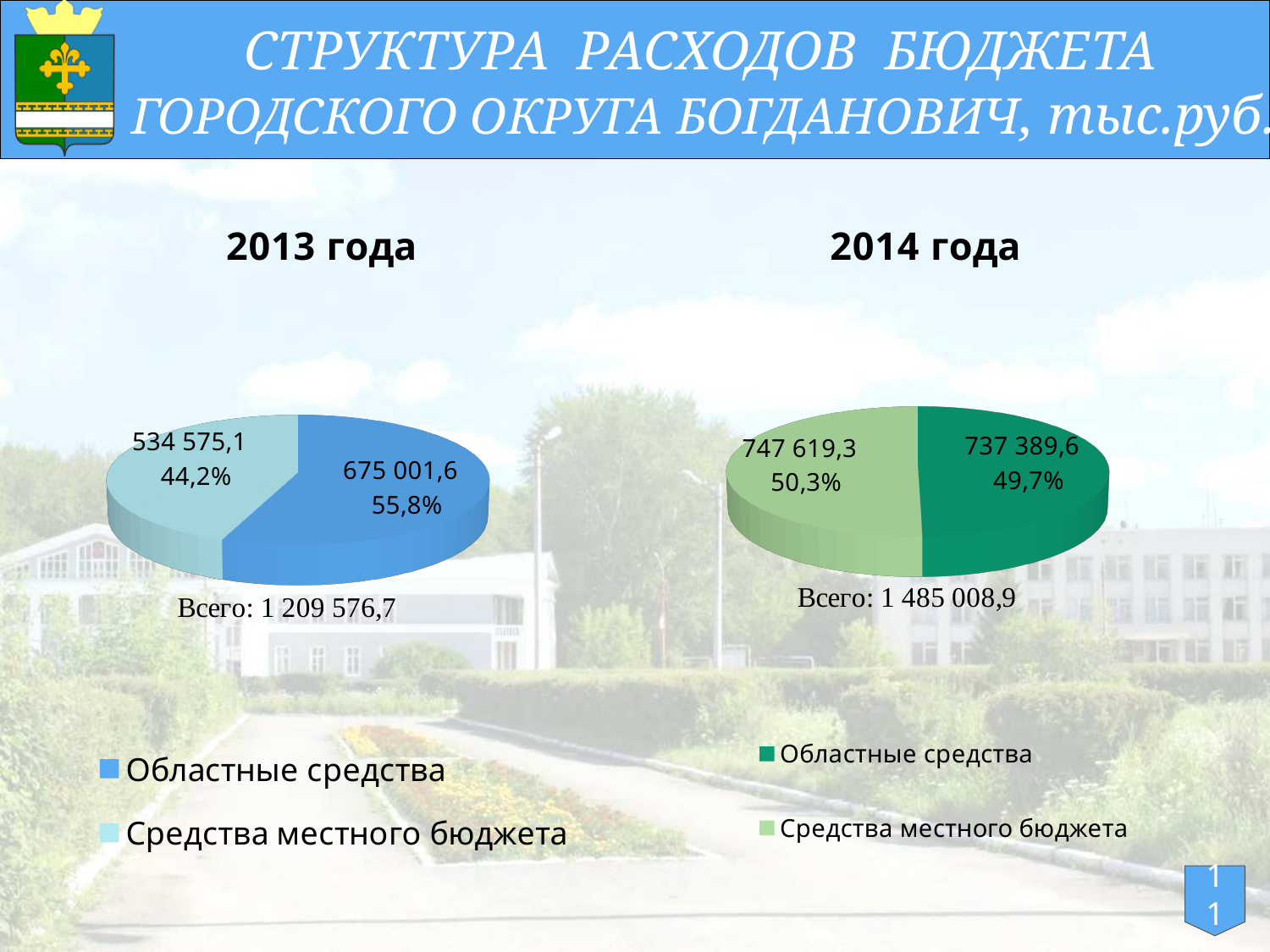
What kind of chart is used for 2013 года? Pie chart How many categories does the 2014 года chart have? 2 On the 2014 года chart, what is the value for Средства местного бюджета? 747 619,3 On the 2013 года chart, what is the value for Средства местного бюджета? 534 575,1 On the 2014 года chart, what is the difference between Средства местного бюджета and Областные средства? 10 229,7 On the 2013 года chart, what is the value for Областные средства? 675 001,6 On the 2014 года chart, what is the value for Областные средства? 737 389,6 On the 2013 года chart, which category is the largest? Областные средства On the 2013 года chart, what is the difference between Областные средства and Средства местного бюджета? 140 426,5 On the 2014 года chart, what share of the pie is Средства местного бюджета? 50,3% On the 2013 года chart, what share of the pie is Областные средства? 55,8% What is the total (Всего) shown for the 2014 года chart? 1 485 008,9